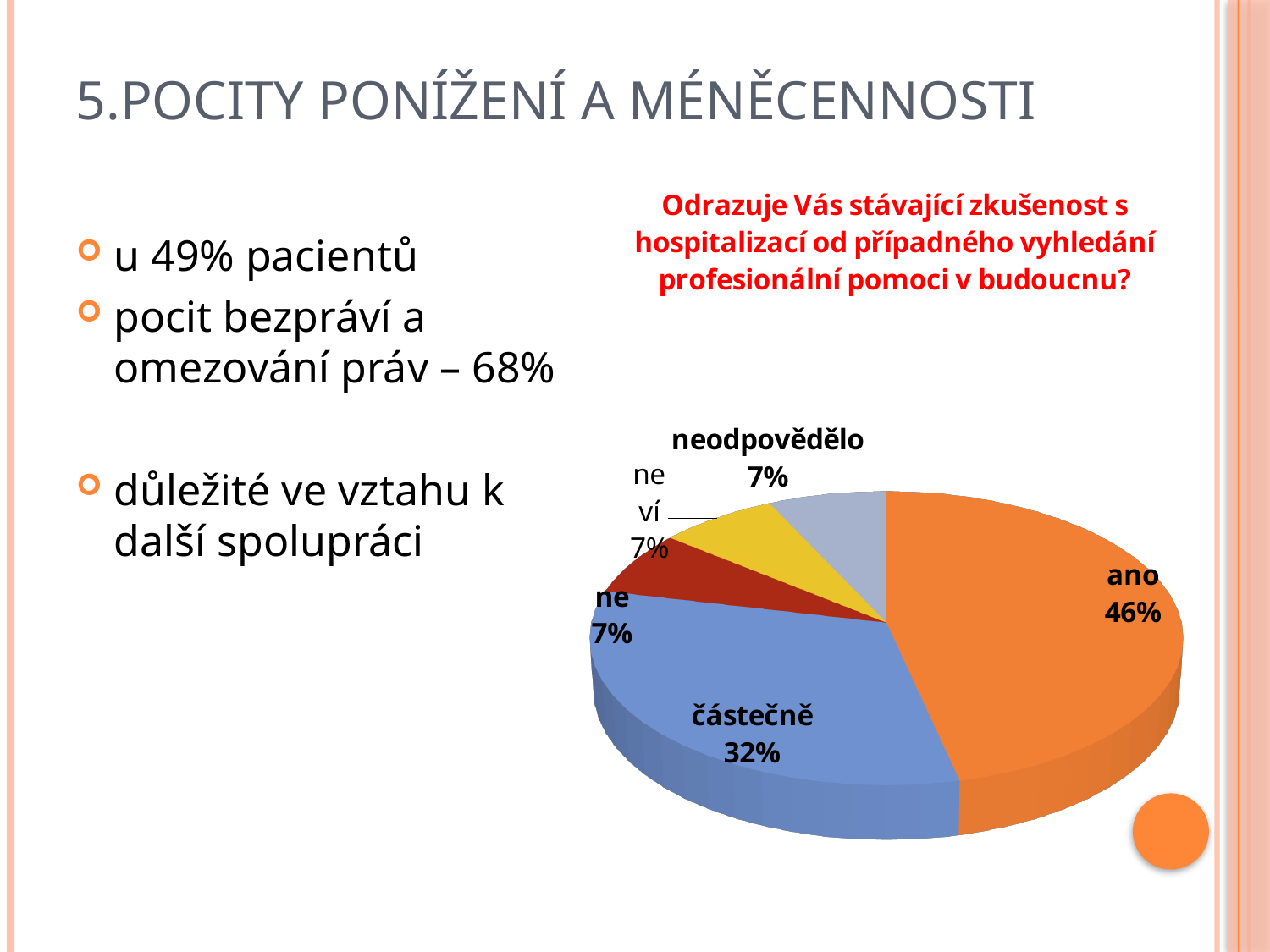
What share of the pie does the "ne" slice represent? 7% What question does the chart title ask? Odrazuje Vás stávající zkušenost s hospitalizací od případného vyhledání profesionální pomoci v budoucnu? What colour is the "ano" slice of the pie chart? orange What kind of chart is shown on the slide? pie chart What is the difference in percentage points between the "ano" and "částečně" slices? 14 What is the combined share of the "ano" and "částečně" slices? 78% What share of the pie does the "neodpovědělo" slice represent? 7% What share of the pie does the "částečně" slice represent? 32% What share of the pie does the "ano" slice represent? 46% Which category has the largest slice of the pie? ano How many slices does the pie chart have? 5 Which slice is larger, "částečně" or "neví"? částečně